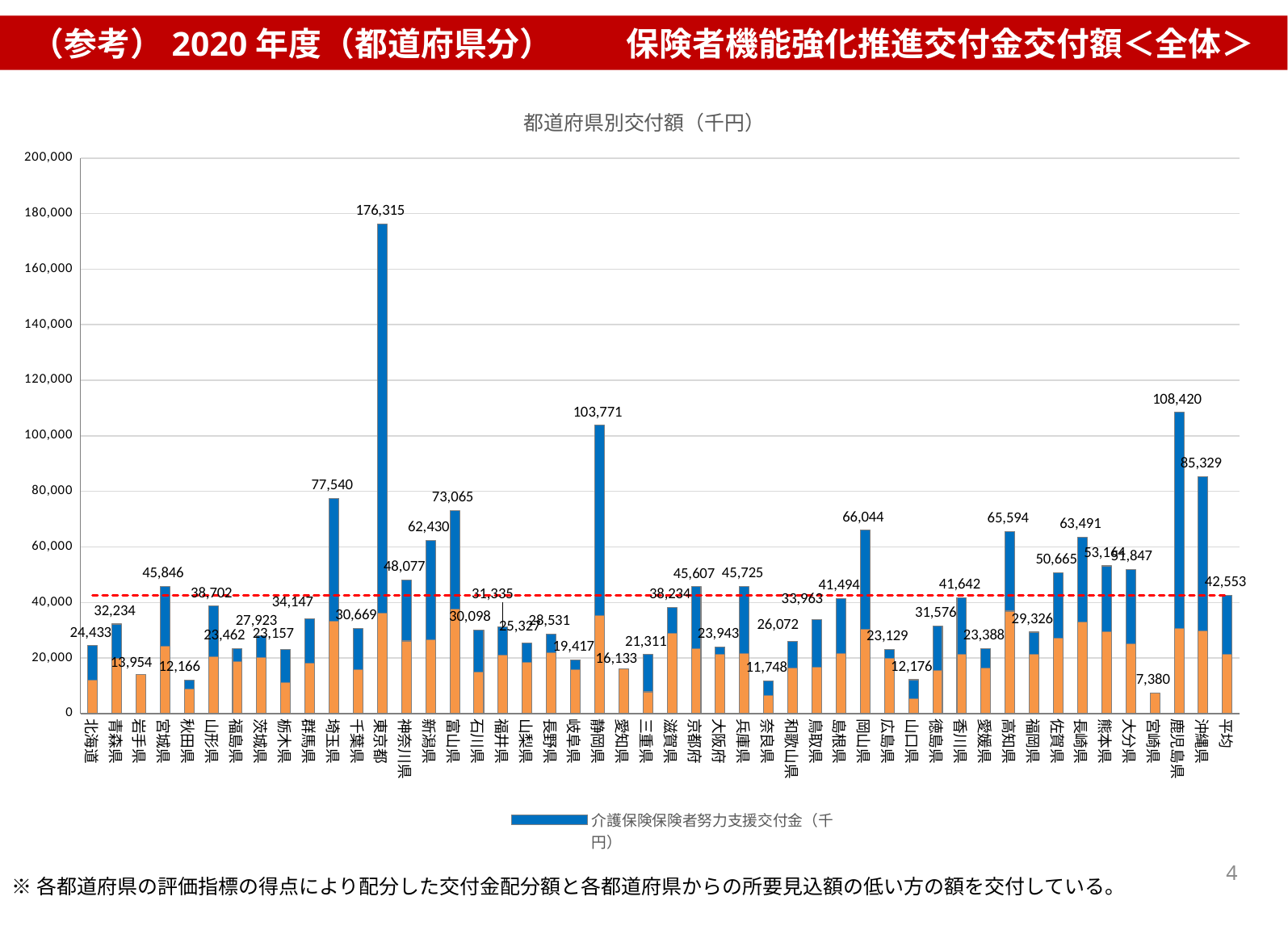
Which is larger, the value for 静岡県 or the value for 埼玉県? 静岡県 What is the value shown for 平均? 42,553 What is the title of the chart? 都道府県別交付額（千円） Is the value for 奈良県 greater or less than 20,000? less What is the value shown for 宮崎県? 7,380 What is the value shown for 岡山県? 66,044 What is the difference between the values for 鹿児島県 and 沖縄県? 23,091 Which prefecture has the lowest value in the chart? 宮崎県 What kind of chart is shown on the slide? bar chart Which category has the highest value in the chart? 東京都 How many categories are shown on the x axis? 48 What is the value shown for 東京都? 176,315